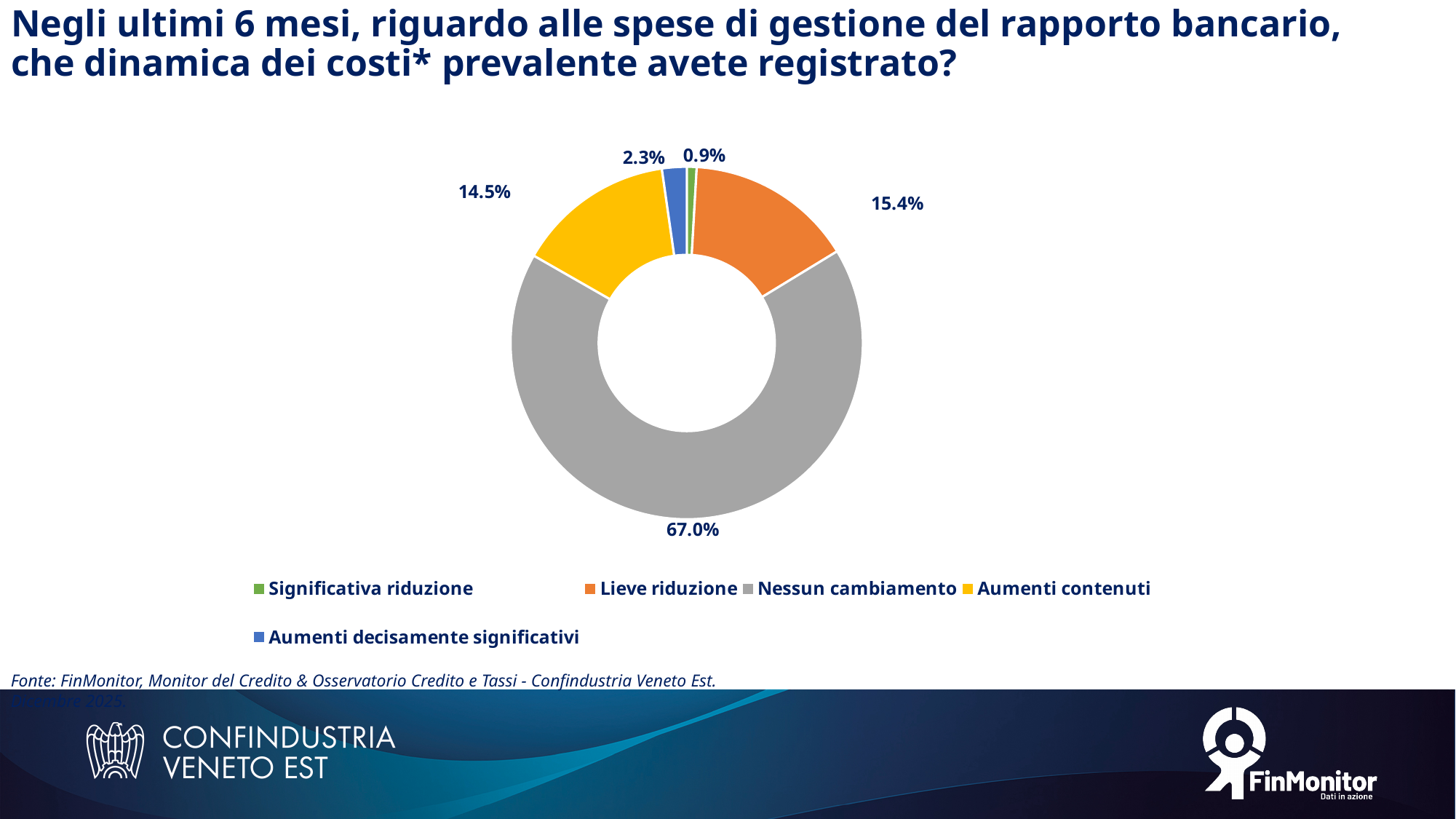
Which category has the largest share? Nessun cambiamento How many categories does the chart show? 5 What is the value for "Aumenti contenuti"? 14.5% What is the value for "Aumenti decisamente significativi"? 2.3% What is the difference between "Lieve riduzione" and "Aumenti contenuti"? 0.9% Which colour represents "Aumenti contenuti" in the chart? Yellow What share of respondents reported "Nessun cambiamento"? 67.0% Which category has the smallest share? Significativa riduzione Which is larger, "Aumenti decisamente significativi" or "Significativa riduzione"? Aumenti decisamente significativi What is the value for "Lieve riduzione"? 15.4% What kind of chart is shown on the slide? Pie chart (donut) What is the value for "Significativa riduzione"? 0.9%